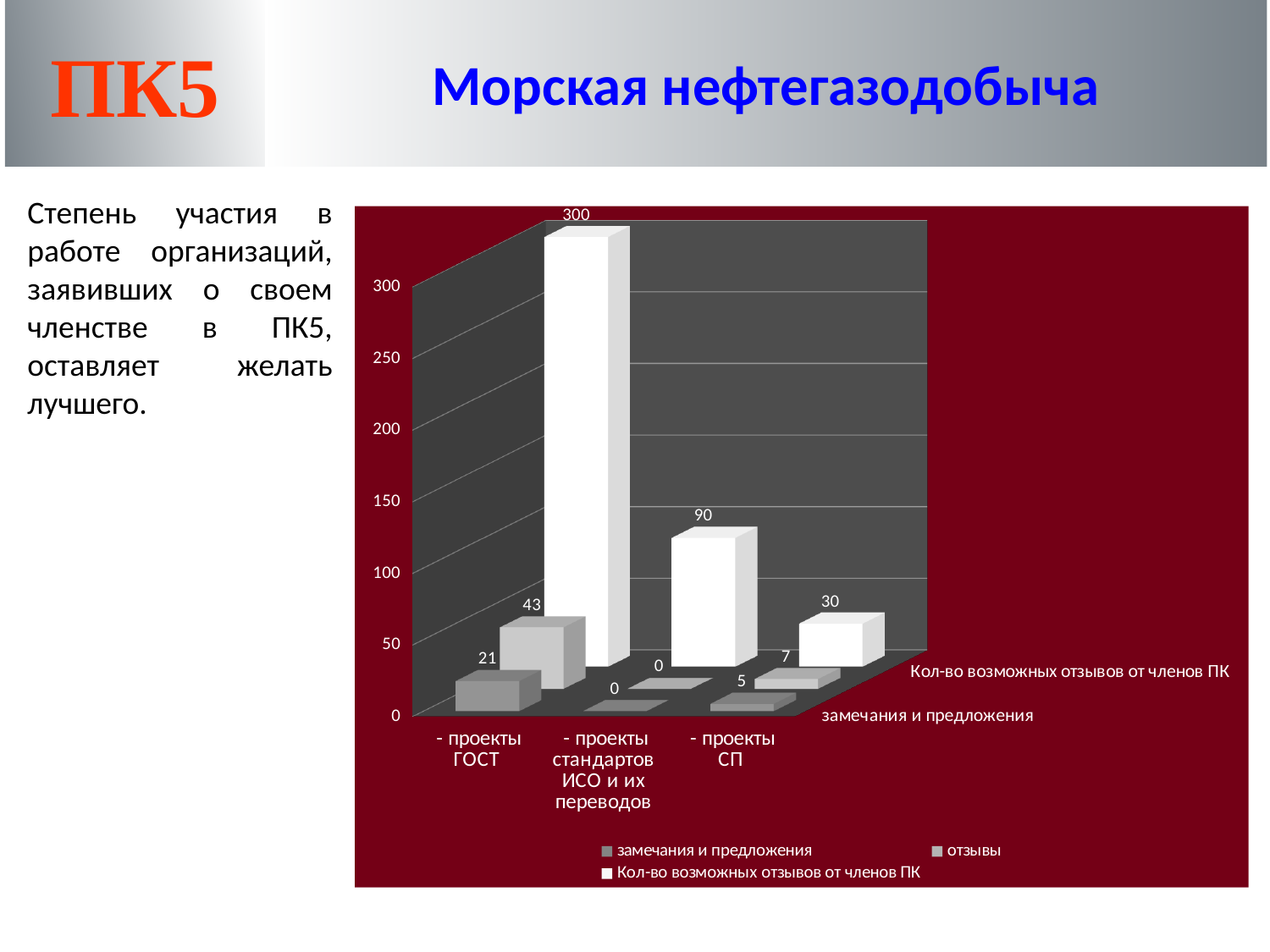
What type of chart is shown on the slide? bar chart What is the difference between "Кол-во возможных отзывов от членов ПК" and "отзывы" for "- проекты ГОСТ"? 257 Which category has the highest value for "Кол-во возможных отзывов от членов ПК"? - проекты ГОСТ What is the value of "Кол-во возможных отзывов от членов ПК" for "- проекты ГОСТ"? 300 What is the value of "Кол-во возможных отзывов от членов ПК" for "- проекты стандартов ИСО и их переводов"? 90 How many series does the chart legend list? 3 What is the value of "отзывы" for "- проекты ГОСТ"? 43 Which is larger for "- проекты СП": "отзывы" or "замечания и предложения"? отзывы Which category has the lowest value for "отзывы"? - проекты стандартов ИСО и их переводов How many categories are shown on the x axis of the chart? 3 What is the value of "замечания и предложения" for "- проекты СП"? 5 Is the value of "Кол-во возможных отзывов от членов ПК" for "- проекты СП" greater or less than 50? less